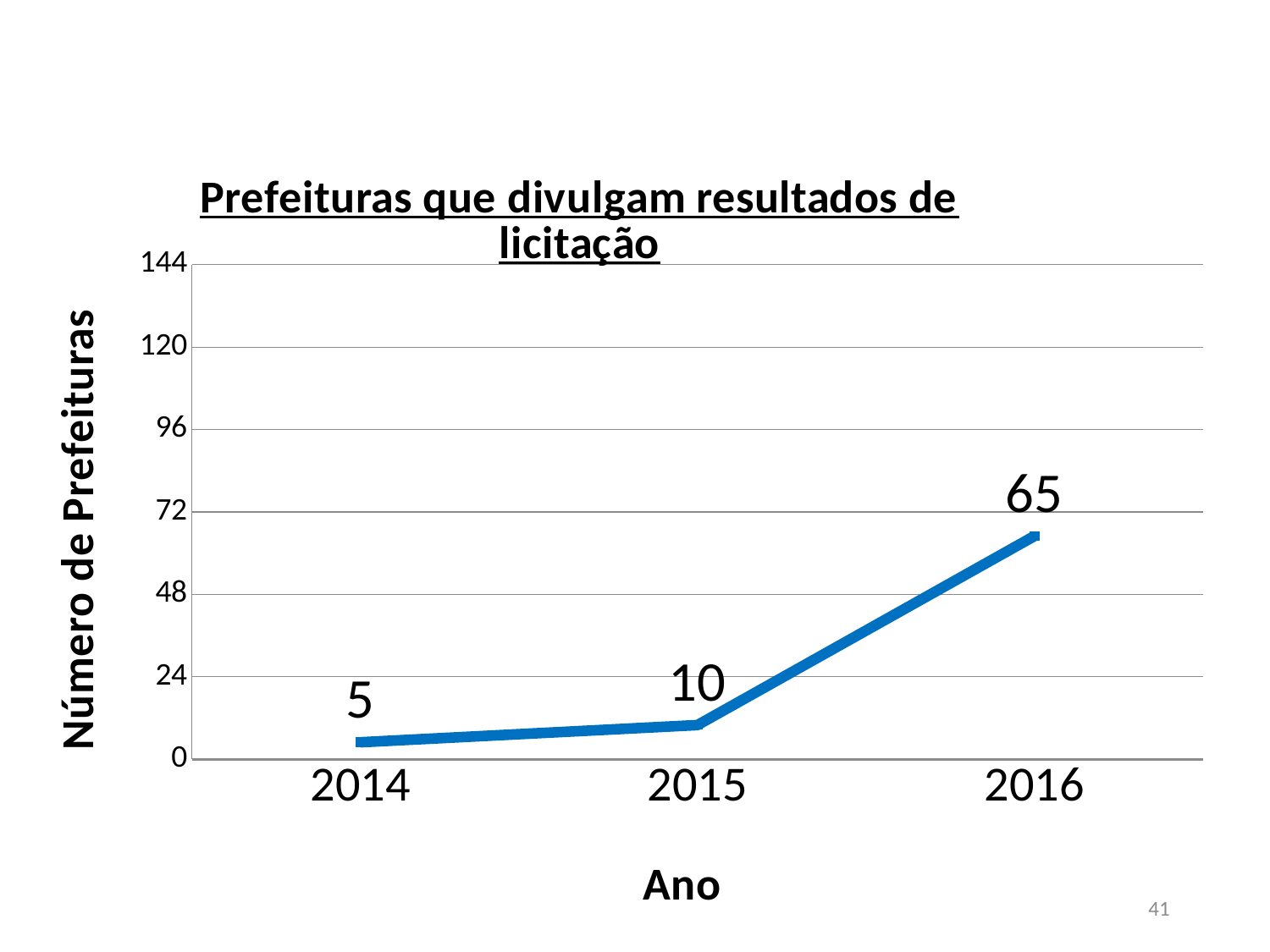
Which is larger, the value for 2015 or the value for 2014? 2015 What is the value for 2014? 5 Do the values rise or fall from 2014 to 2016? rise What is the difference between the values for 2016 and 2015? 55 How many years are plotted on the chart? 3 Which year has the lowest value? 2014 What is the value for 2015? 10 What is the value for 2016? 65 Which year has the highest value? 2016 Is the value for 2016 greater or less than 48? greater What is the difference between the values for 2015 and 2014? 5 What kind of chart is shown on the slide? line chart